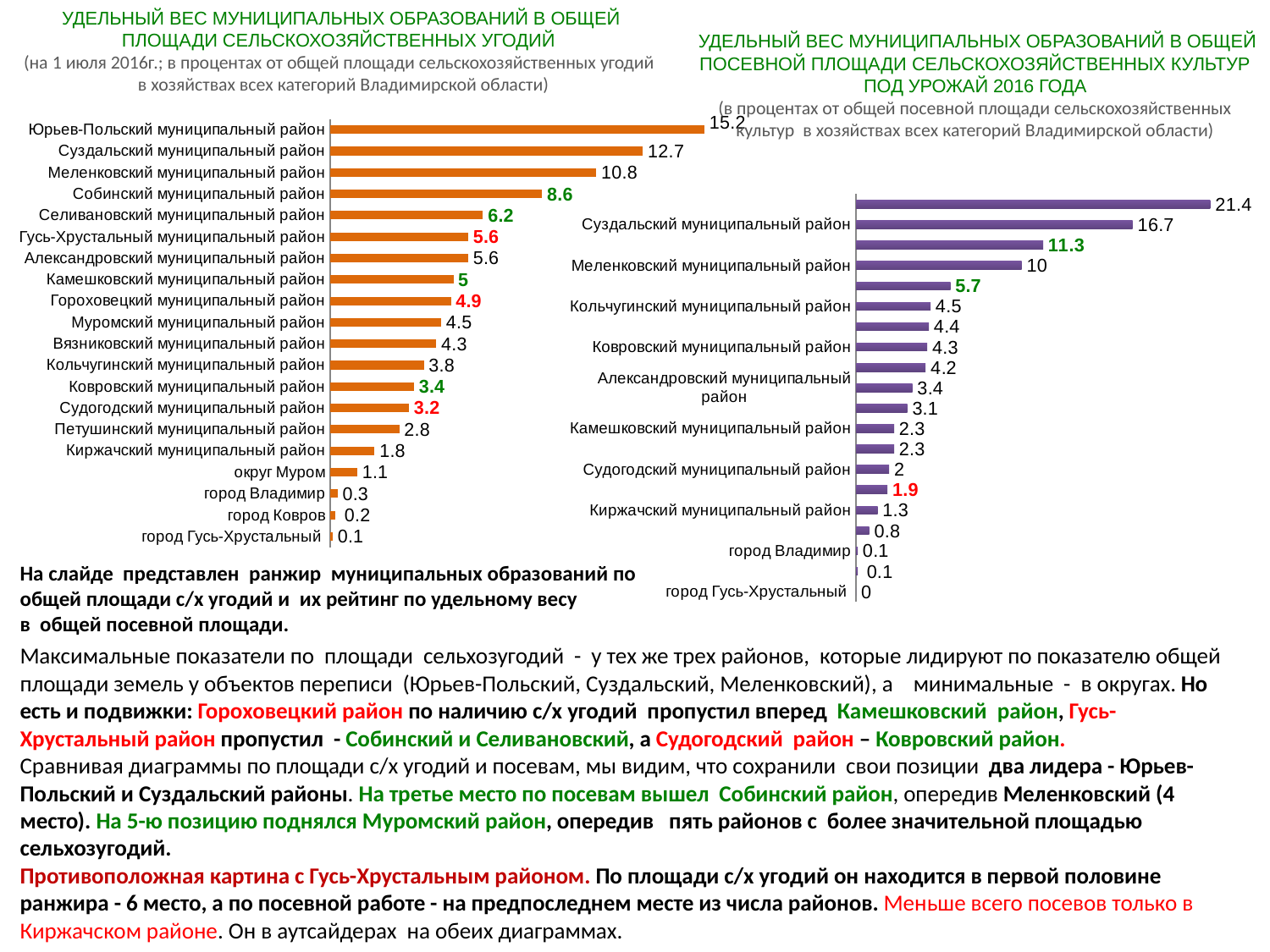
On the right chart (share of total sown area), what is the highest value shown? 21.4 On the left chart (share of total agricultural land), what is the value for город Владимир? 0.3 On the left chart (share of total agricultural land), which category has the lowest value? город Гусь-Хрустальный On the right chart (share of total sown area), what is the value for город Гусь-Хрустальный? 0 On the right chart (share of total sown area), what is the value for Суздальский муниципальный район? 16.7 On the left chart (share of total agricultural land), what is the value for Гороховецкий муниципальный район? 4.9 On the left chart (share of total agricultural land), which category has the highest value? Юрьев-Польский муниципальный район What kind of chart is the left chart (share of total agricultural land)? Bar chart On the left chart (share of total agricultural land), what is the value for Юрьев-Польский муниципальный район? 15.2 How many categories are shown on the left chart (share of total agricultural land)? 20 On the left chart (share of total agricultural land), what is the difference between Суздальский муниципальный район and Меленковский муниципальный район? 1.9 On the left chart (share of total agricultural land), which is larger: Муромский муниципальный район or Вязниковский муниципальный район? Муромский муниципальный район